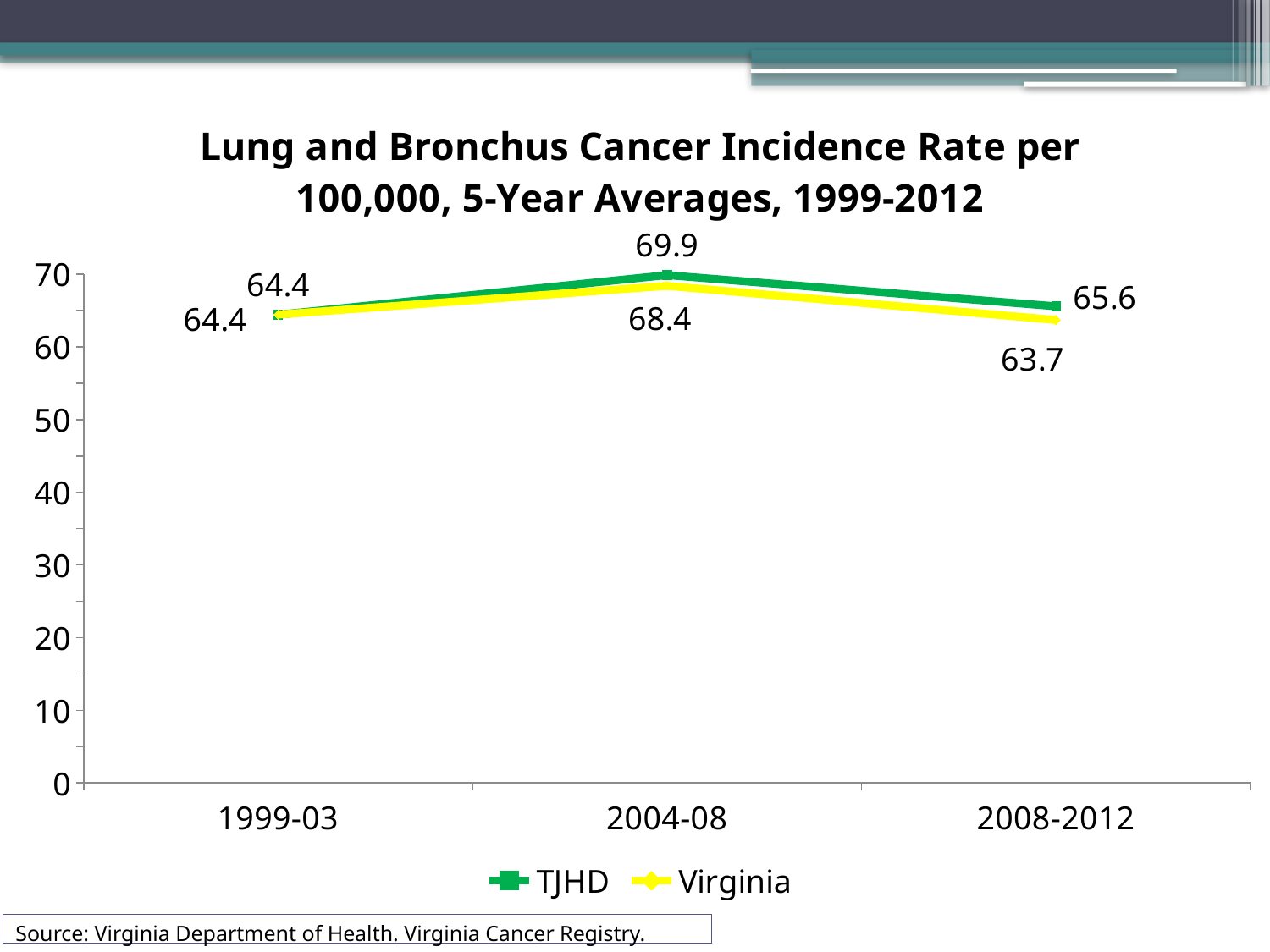
What is the Virginia lung and bronchus cancer incidence rate for 2008-2012? 63.7 What type of chart is shown on the slide? line chart What is the TJHD incidence rate for 1999-03? 64.4 What is the Virginia incidence rate for 2004-08? 68.4 What is the difference between the TJHD and Virginia incidence rates in 2008-2012? 1.9 Which is larger in 2004-08, the TJHD rate or the Virginia rate? TJHD What is the TJHD lung and bronchus cancer incidence rate for 2004-08? 69.9 How many series does the legend list? 2 Does the Virginia incidence rate rise or fall from 2004-08 to 2008-2012? fall How many time periods are shown on the x axis? 3 In which period is the TJHD incidence rate highest? 2004-08 In which period is the Virginia incidence rate lowest? 2008-2012